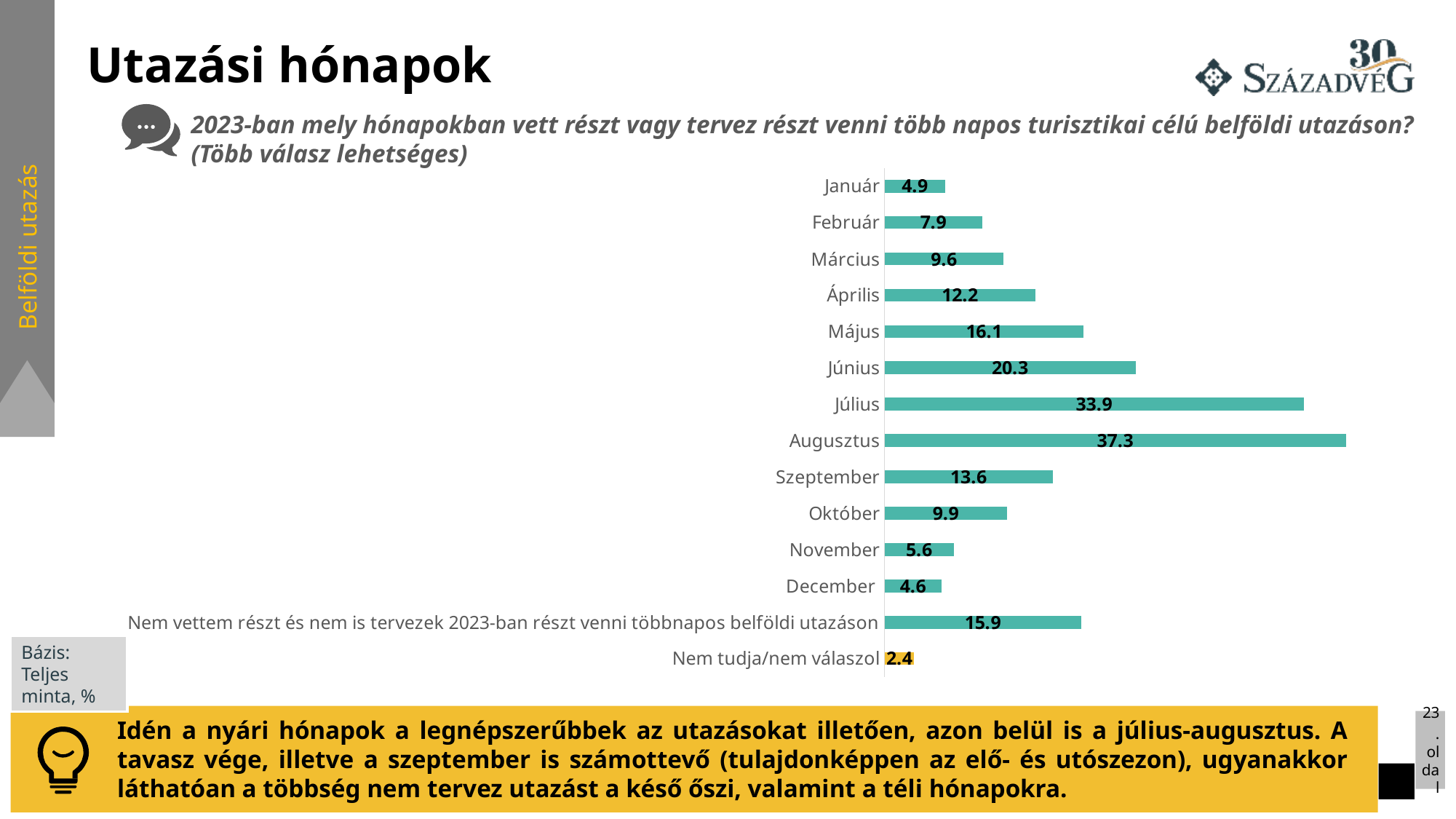
Which month has the lowest value? December Which category has the lowest value? Nem tudja/nem válaszol What is the difference between the values for Augusztus and Július? 3.4 Which category has the highest value? Augusztus What is the difference between the values for Június and Május? 4.2 What is the value for Január? 4.9 How many categories are shown in the chart? 14 What is the value for the category 'Nem vettem részt és nem is tervezek 2023-ban részt venni többnapos belföldi utazáson'? 15.9 Which is larger, the value for Október or the value for Március? Október What is the value for Augusztus? 37.3 What kind of chart is shown on the slide? Bar chart What is the value for Szeptember? 13.6